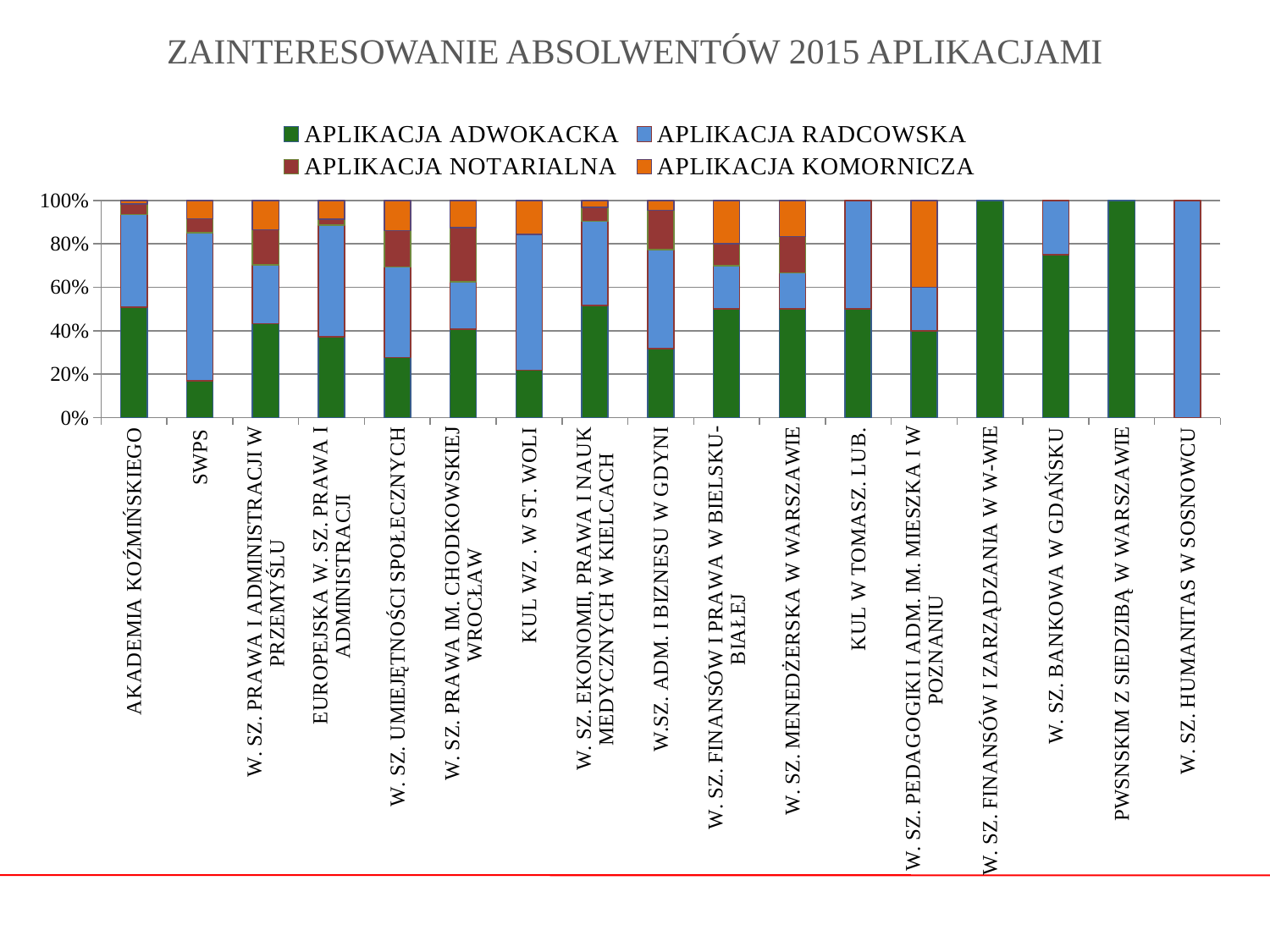
What is the title of the chart? ZAINTERESOWANIE ABSOLWENTÓW 2015 APLIKACJAMI How many universities (categories) are shown on the x axis? 17 What kind of chart is shown on the slide? Stacked bar chart Is the value for APLIKACJA ADWOKACKA at W. SZ. PEDAGOGIKI I ADM. IM. MIESZKA I W POZNANIU greater or less than 60%? less Is the value for APLIKACJA ADWOKACKA at W. SZ. BANKOWA W GDAŃSKU greater or less than 60%? greater Which is larger at SWPS: the APLIKACJA ADWOKACKA share or the APLIKACJA RADCOWSKA share? APLIKACJA RADCOWSKA Which colour represents APLIKACJA KOMORNICZA in the legend? Orange Is the value for APLIKACJA ADWOKACKA at SWPS greater or less than 20%? less How many series does the legend list? 4 What is the value for APLIKACJA ADWOKACKA at PWSNSKIM Z SIEDZIBĄ W WARSZAWIE? 100% What is the value for APLIKACJA RADCOWSKA at W. SZ. HUMANITAS W SOSNOWCU? 100% What is the value for APLIKACJA ADWOKACKA at W. SZ. FINANSÓW I ZARZĄDZANIA W W-WIE? 100%